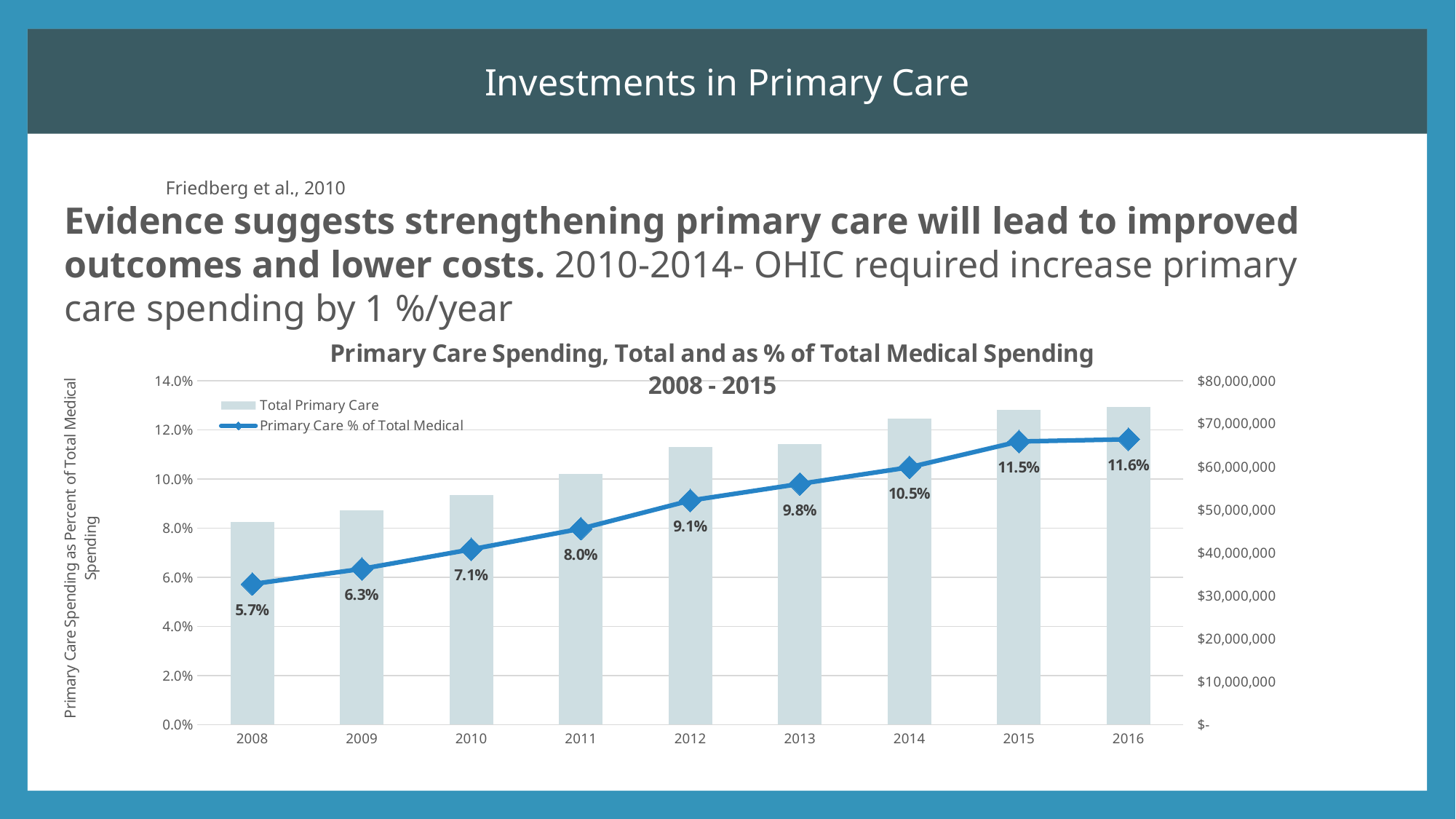
Which year has the highest Primary Care % of Total Medical? 2016 By how many percentage points did Primary Care % of Total Medical increase from 2008 to 2016? 5.9 percentage points Which year has the lowest Primary Care % of Total Medical? 2008 Does the Primary Care % of Total Medical line rise or fall from 2008 to 2016? rise Which year has a higher Primary Care % of Total Medical, 2011 or 2012? 2012 Is the Total Primary Care bar for 2012 greater or less than $60,000,000? greater What is the Primary Care % of Total Medical value for 2016? 11.6% Is the Total Primary Care bar for 2008 greater or less than $50,000,000? less How many series does the chart legend list? 2 What is the Primary Care % of Total Medical value for 2008? 5.7% How many years are shown on the x axis of the chart? 9 What is the Primary Care % of Total Medical value for 2013? 9.8%